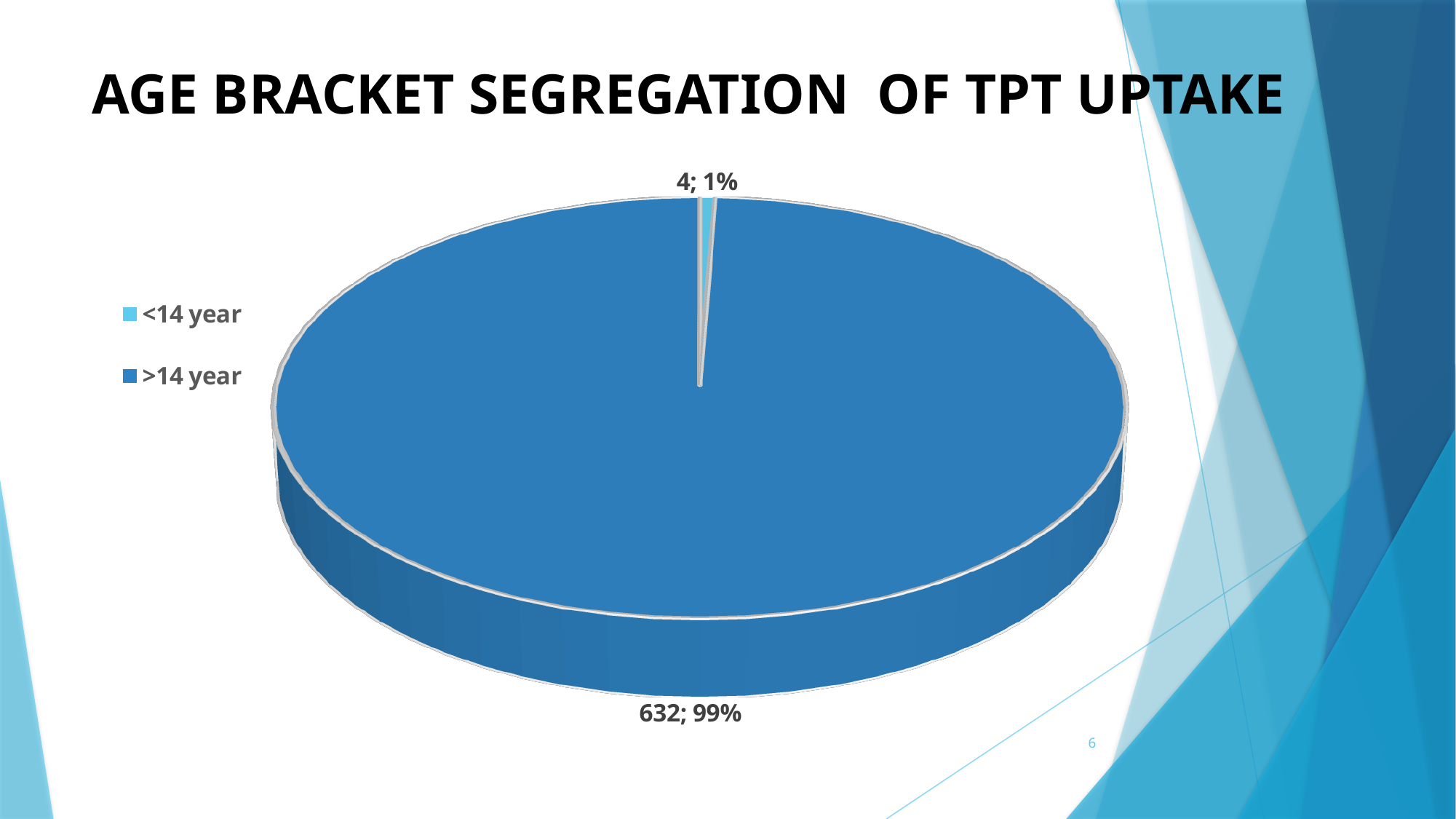
What is the title of the chart? AGE BRACKET SEGREGATION OF TPT UPTAKE What share of the pie does the <14 year slice represent? 1% How many categories does the pie chart show? 2 What is the total of the two values shown in the pie chart? 636 Which category has the largest slice? >14 year What is the difference between the >14 year and <14 year values? 628 What kind of chart is shown on the slide? Pie chart What is the value for the >14 year category? 632 Which is larger, the value for <14 year or the value for >14 year? >14 year What share of the pie does the >14 year slice represent? 99% Which category has the smallest slice? <14 year What is the value for the <14 year category? 4